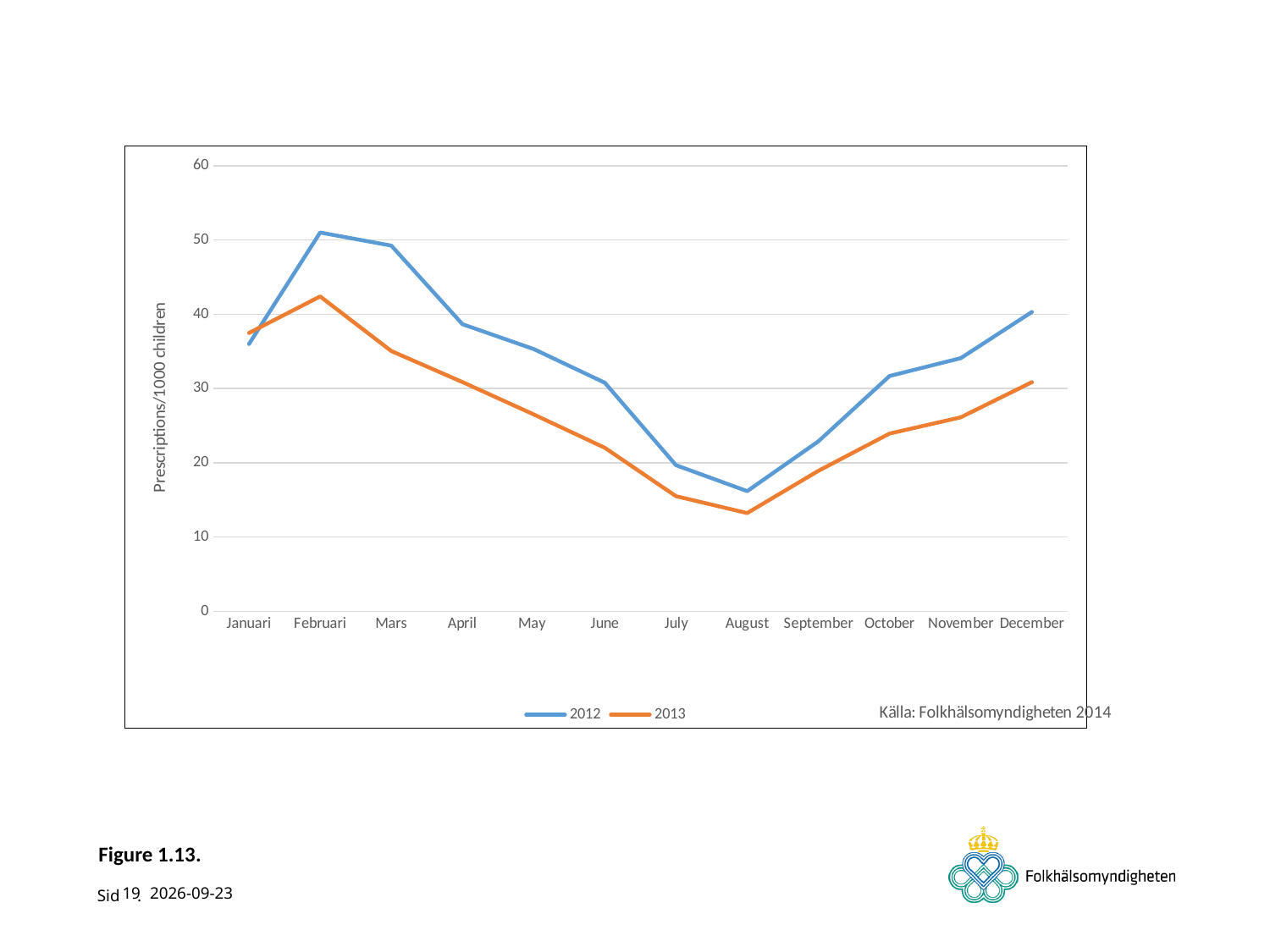
Is the value for 2012 in Februari greater or less than 50? greater Do the 2012 values rise or fall from Februari to August? fall How many months are shown along the x axis? 12 In which month does the 2012 series reach its highest value? Februari In which month does the 2013 series reach its lowest value? August What kind of chart is shown on the slide? line chart Is the value for 2013 in August greater or less than 20? less What is the label on the vertical axis? Prescriptions/1000 children In which month does the 2012 series reach its lowest value? August How many series does the legend list? 2 In Februari, which series has the larger value, 2012 or 2013? 2012 Is the value for 2013 in Februari greater or less than 40? greater